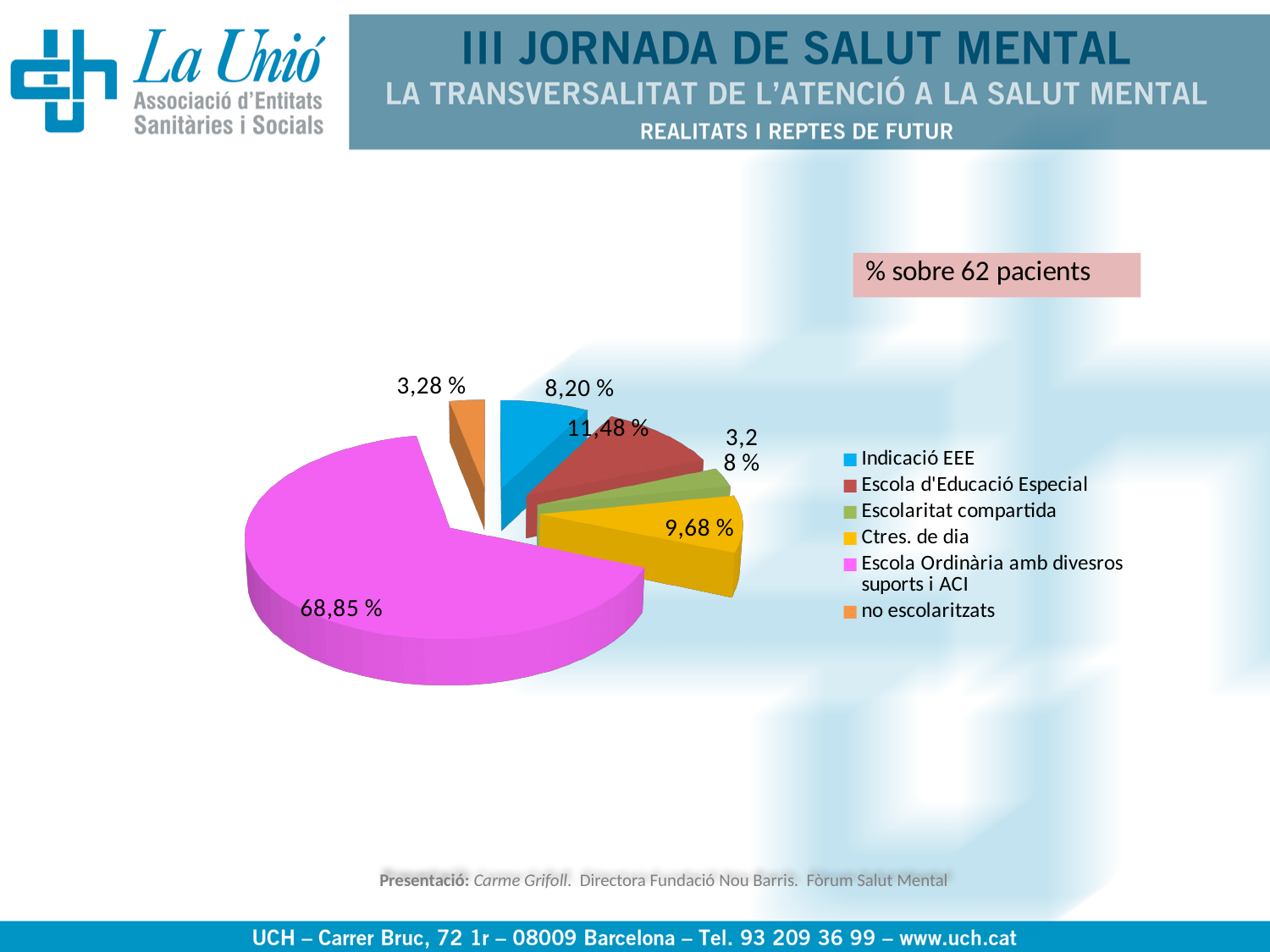
How many categories does the legend list? 6 Which is larger, the share for Escola d'Educació Especial or the share for Ctres. de dia? Escola d'Educació Especial What colour is the slice for Ctres. de dia? yellow What kind of chart is shown on the slide? pie chart Which category has the largest share of the pie? Escola Ordinària amb divesros suports i ACI What percentage is shown for Ctres. de dia? 9,68 % What is the difference between the share for Escola d'Educació Especial and the share for Indicació EEE? 3,28 % What percentage is shown for no escolaritzats? 3,28 % What percentage is shown for Escola d'Educació Especial? 11,48 % What percentage is shown for Indicació EEE? 8,20 % According to the text box on the slide, how many patients are the percentages based on? 62 What percentage is shown for Escola Ordinària amb divesros suports i ACI? 68,85 %